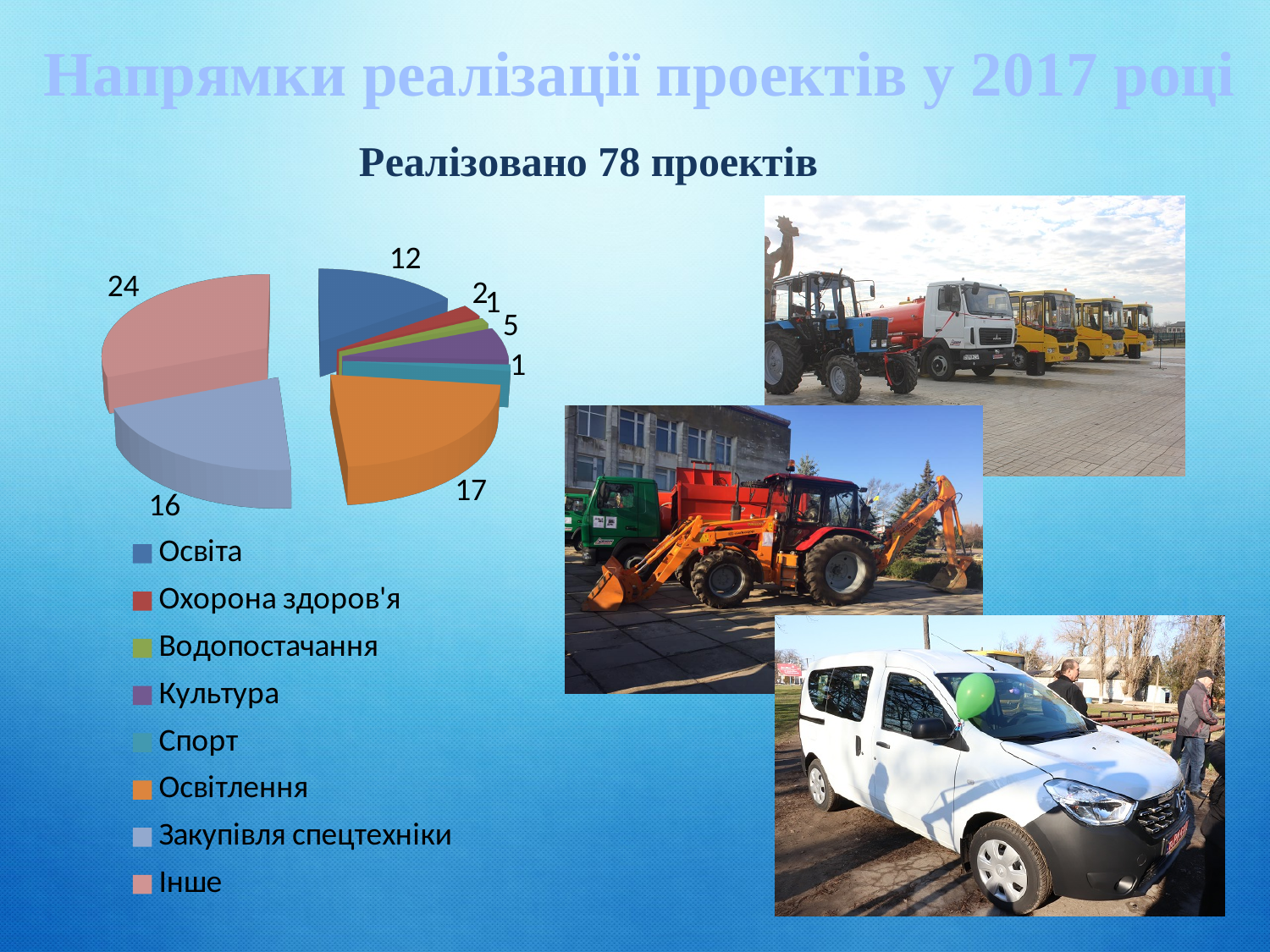
What is the value for Закупівля спецтехніки? 16 What is the value for Освітлення? 17 What is the value for Культура? 5 How many categories does the legend list? 8 What is the difference between the values for Інше and Освітлення? 7 What is the title of the slide? Напрямки реалізації проектів у 2017 році How many projects are shown for Освіта? 12 Which category has the largest slice of the pie? Інше What kind of chart is shown on the slide? pie chart Which is larger, Освітлення or Закупівля спецтехніки? Освітлення What is the total of all the slice values in the pie chart? 78 What is the value for Інше? 24